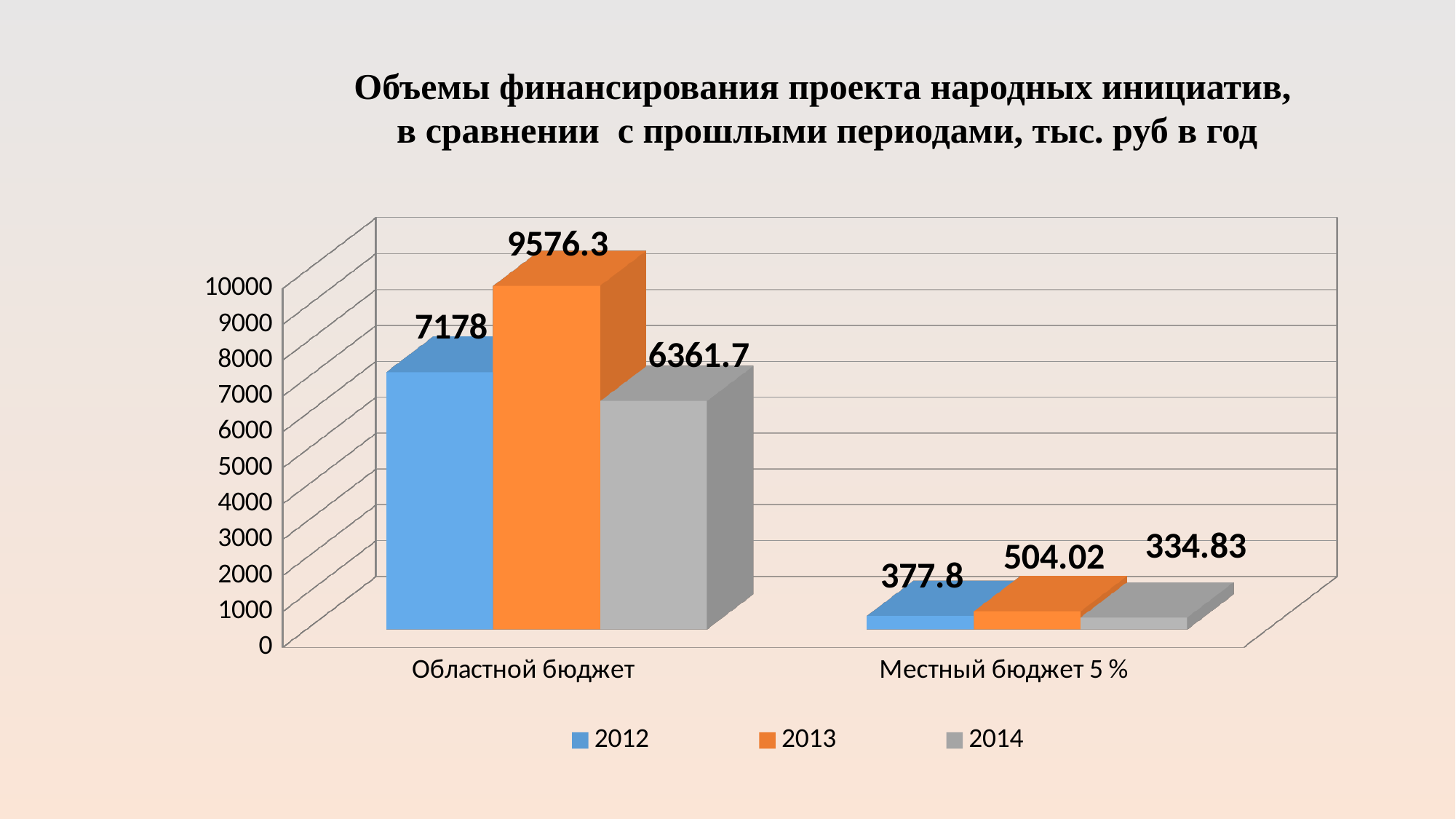
What kind of chart is shown on the slide? Bar chart How many series does the legend list? 3 What is the value for 2013 in the Областной бюджет category? 9576.3 Which year has the lowest value in the Местный бюджет 5 % category? 2014 Which is larger: the 2012 value or the 2014 value in the Областной бюджет category? 2012 What is the value for 2014 in the Местный бюджет 5 % category? 334.83 How many categories are shown on the x axis? 2 What is the value for 2014 in the Областной бюджет category? 6361.7 What is the difference between the 2013 and 2012 values in the Областной бюджет category? 2398.3 Which year has the highest value in the Областной бюджет category? 2013 Which colour represents the 2013 series in the legend? Orange What is the value for 2012 in the Местный бюджет 5 % category? 377.8